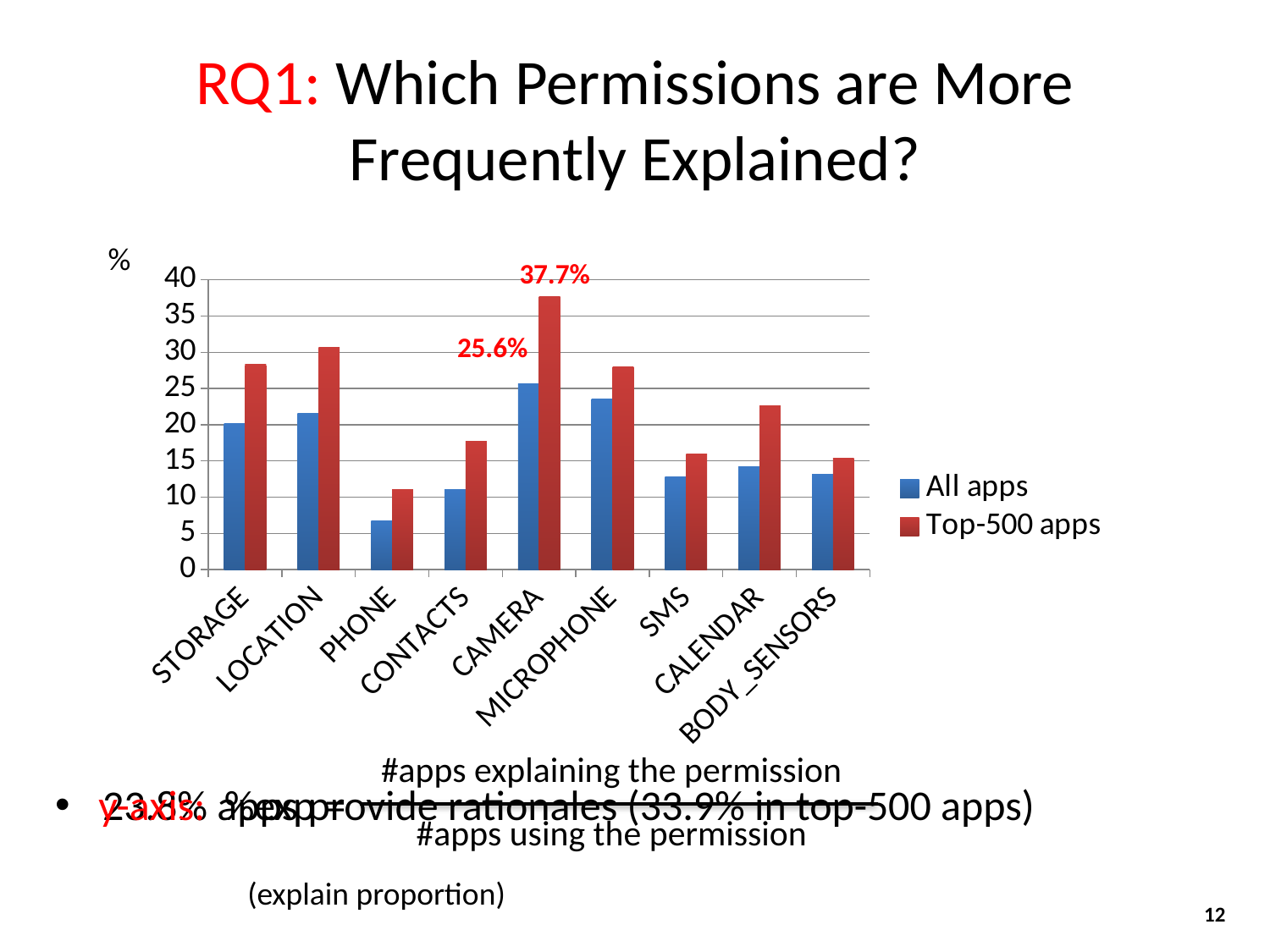
How many series does the legend list? 2 Which permission has the lowest value for All apps? PHONE What kind of chart is shown on the slide? Bar chart Which permission has the highest value for Top-500 apps? CAMERA Is the value for Top-500 apps for STORAGE greater or less than 25? greater What is the difference between the Top-500 apps and All apps values for CAMERA? 12.1% How many permission categories are shown on the x axis? 9 For STORAGE, which series has the larger value, All apps or Top-500 apps? Top-500 apps Is the value for All apps for PHONE greater or less than 10? less What is the value for Top-500 apps for CAMERA? 37.7% What is the value for All apps for CAMERA? 25.6% Which permission has the lowest value for Top-500 apps? PHONE